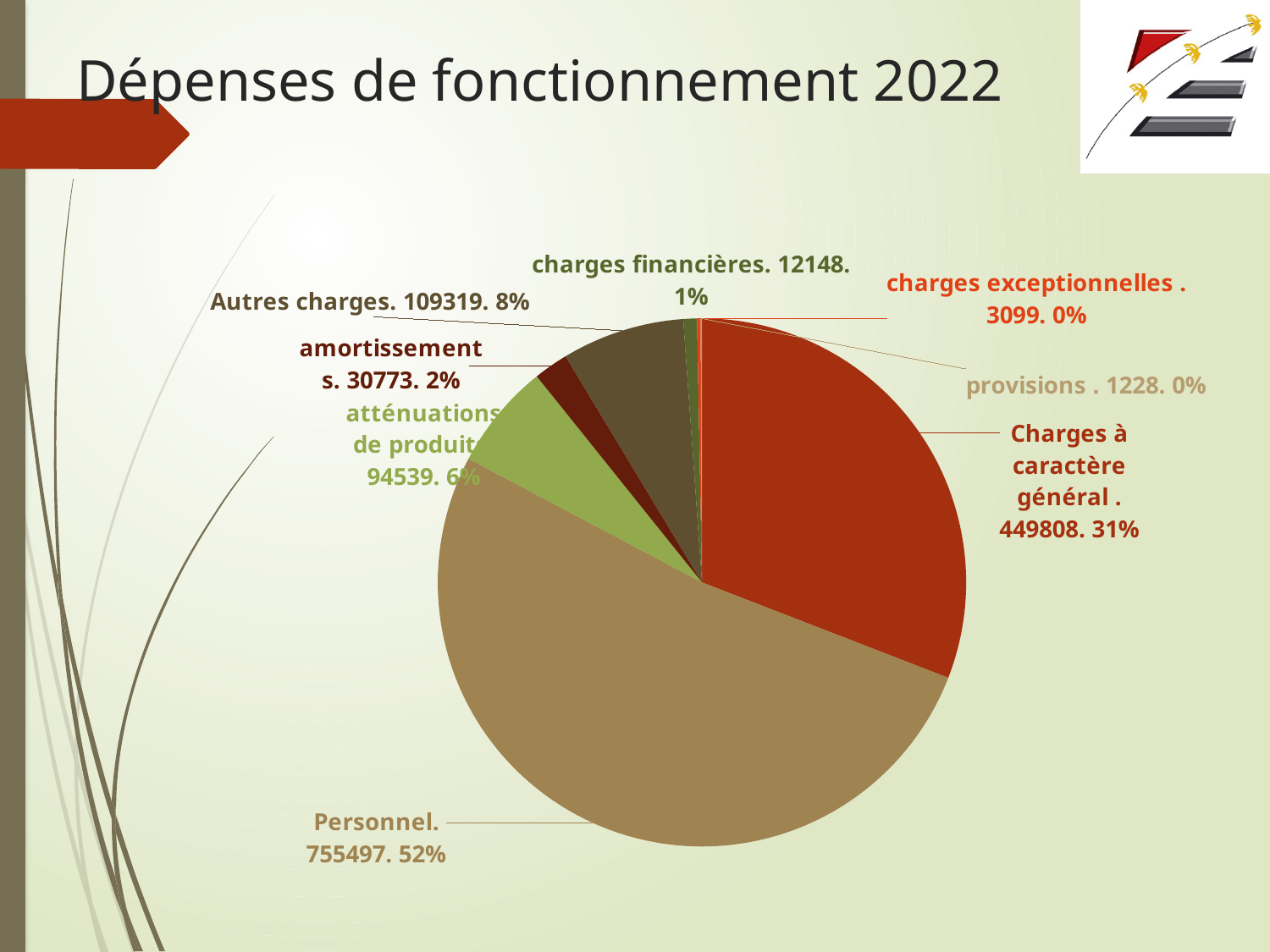
Which category has the largest slice of the pie? Personnel What is the value shown for charges financières? 12148 What is the value shown for Charges à caractère général? 449808 What kind of chart is shown on the slide? pie chart Which category has the smallest value in the pie chart? provisions What share of the pie does atténuations de produit represent? 6% What is the value shown for Personnel? 755497 How many categories are shown in the pie chart? 8 Which is larger, the value for Autres charges or the value for atténuations de produit? Autres charges What is the value shown for Autres charges? 109319 What share of the pie does Personnel represent? 52% What is the difference between the values for Personnel and Charges à caractère général? 305689